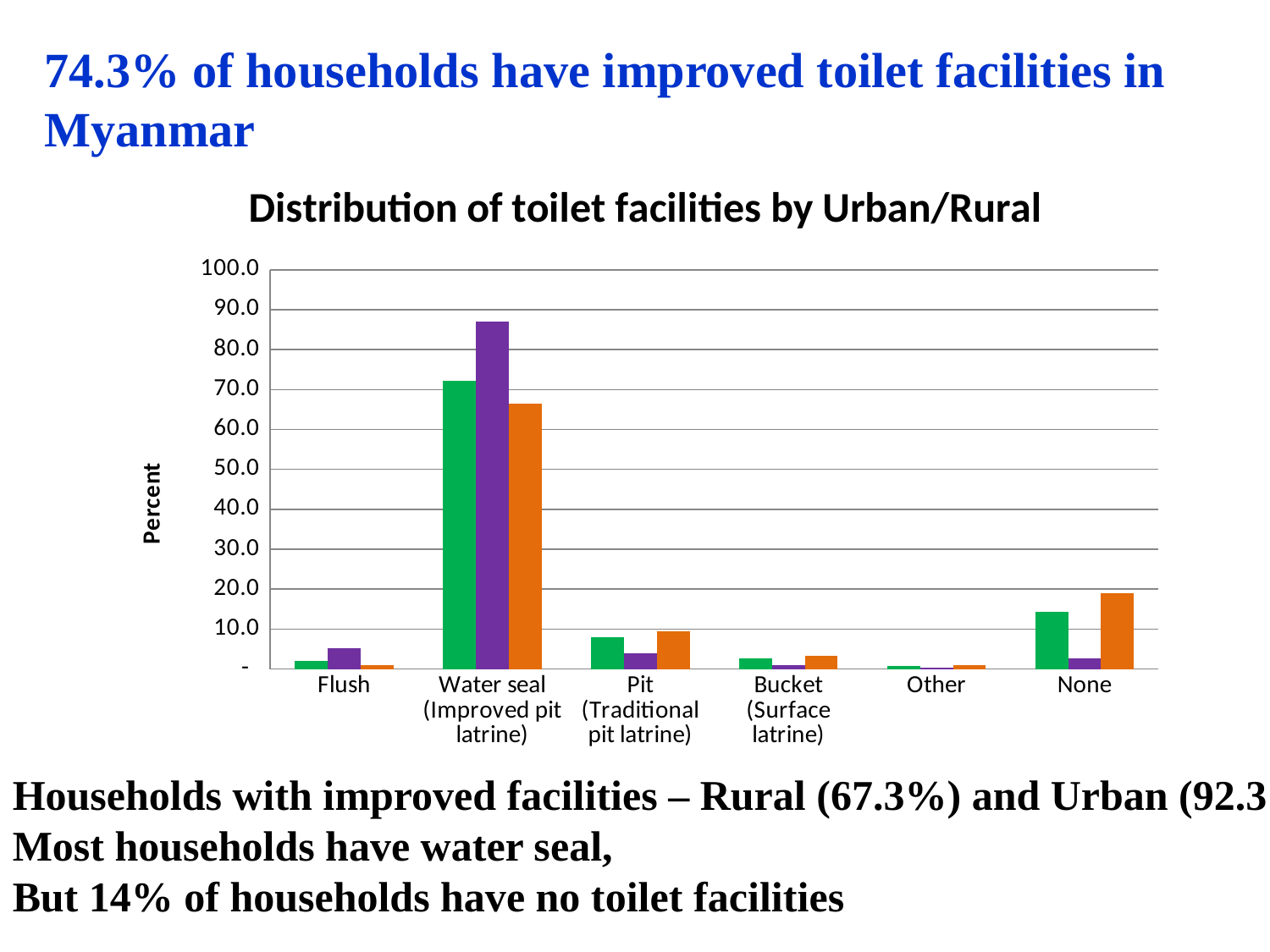
What kind of chart is shown on the slide? bar chart How many toilet facility categories are shown on the x axis? 6 Which toilet facility category has the shortest bars? Other Which toilet facility category has the tallest bars? Water seal (Improved pit latrine) What is the label on the vertical axis of the chart? Percent Is the orange bar for None greater or less than 10.0? greater Is the purple bar for Flush greater or less than 10.0? less What is the title of the chart? Distribution of toilet facilities by Urban/Rural Is the orange bar for Water seal (Improved pit latrine) greater or less than 70.0? less For Water seal (Improved pit latrine), which is larger, the purple bar or the orange bar? the purple bar For None, which is larger, the orange bar or the purple bar? the orange bar